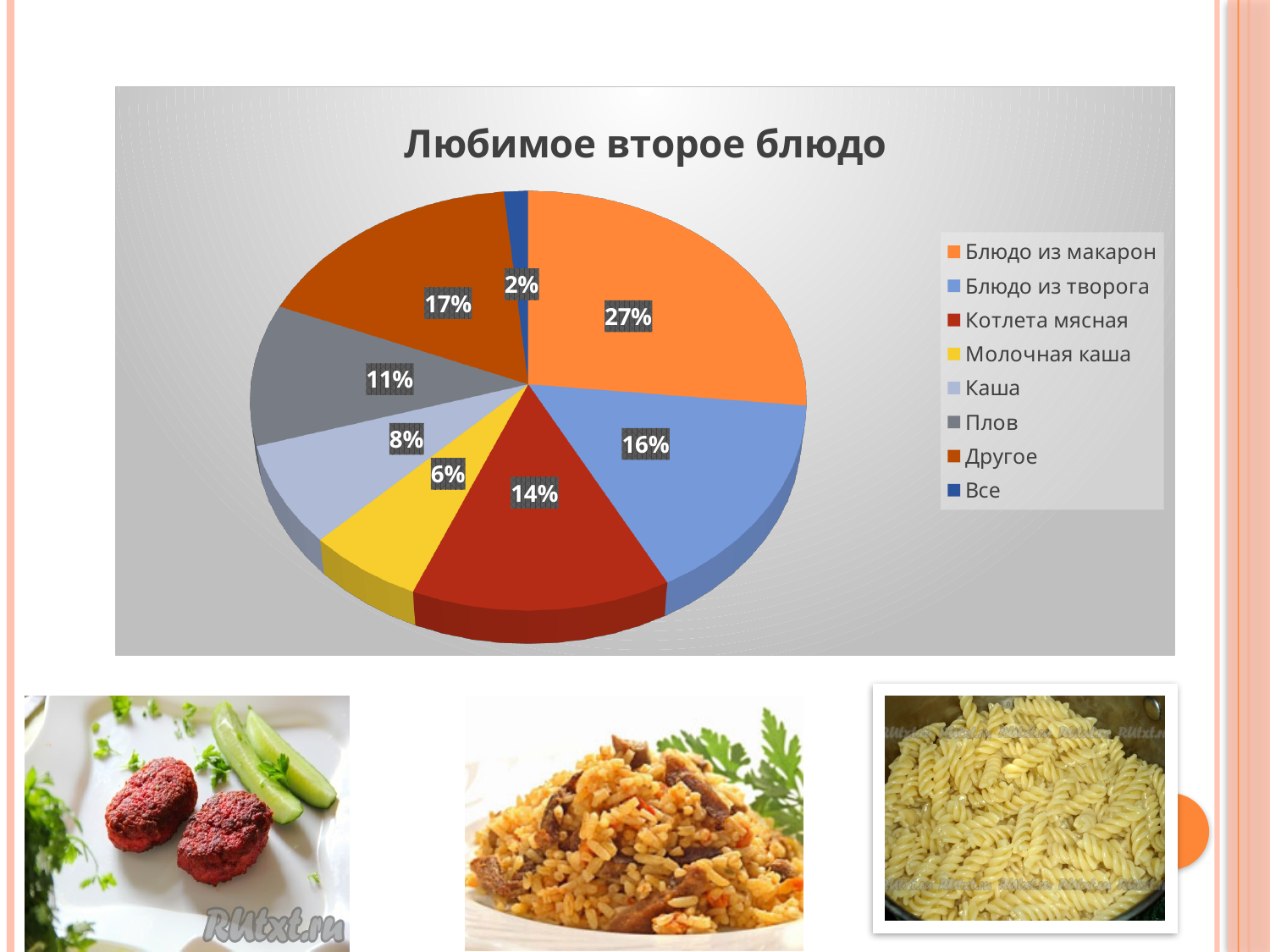
Which is larger, the value for "Каша" or the value for "Молочная каша"? Каша What is the difference between the values for "Другое" and "Блюдо из творога"? 1% What share of the pie does "Блюдо из макарон" have? 27% What is the title of the chart? Любимое второе блюдо Which category has the largest slice of the pie? Блюдо из макарон What is the value shown for "Плов"? 11% What is the value shown for "Молочная каша"? 6% What kind of chart is shown on the slide? Pie chart What is the value shown for "Котлета мясная"? 14% How many categories does the legend list? 8 Which category has the smallest slice of the pie? Все What is the combined share of "Блюдо из макарон" and "Блюдо из творога"? 43%